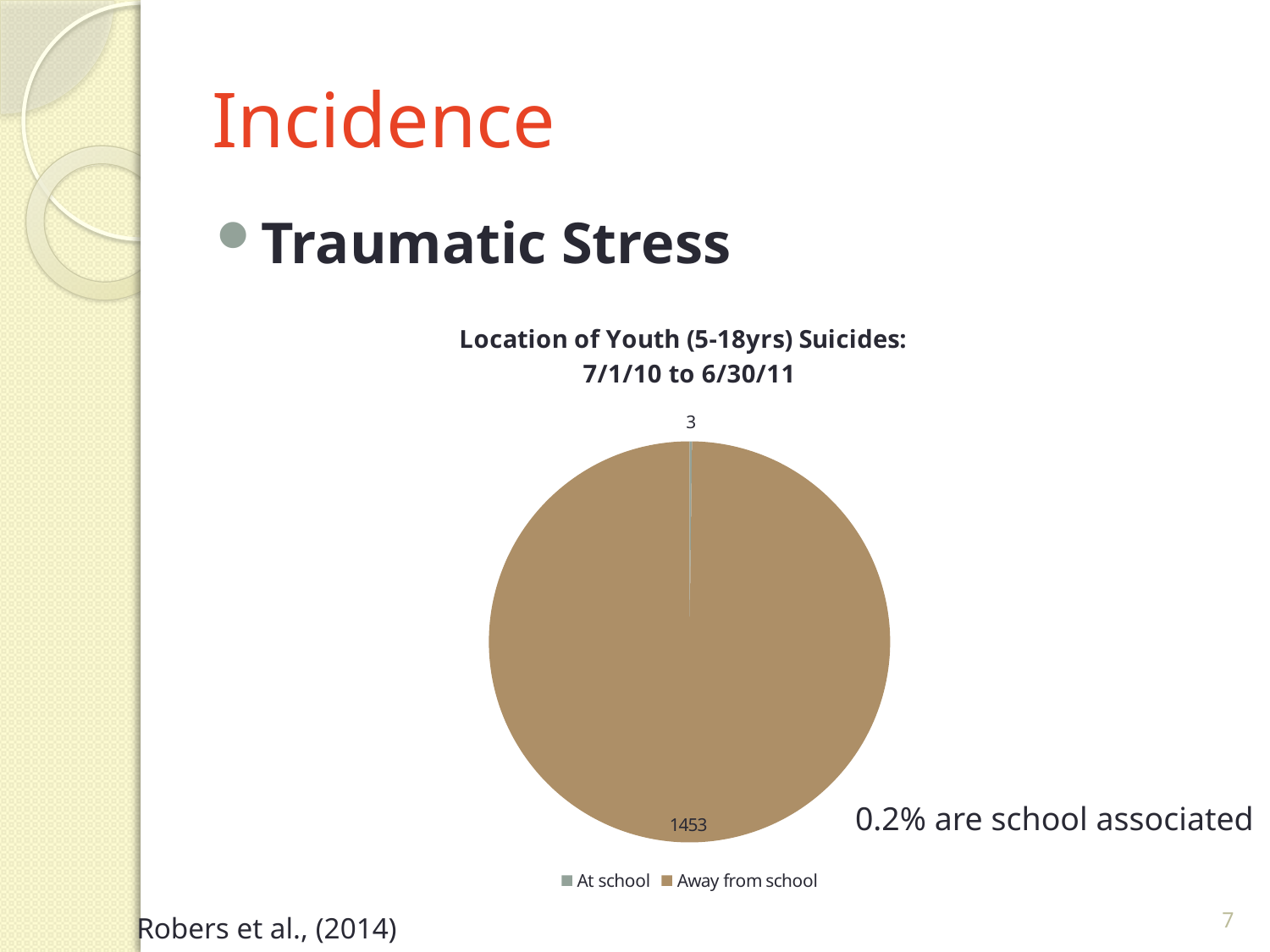
Which is larger: the number of suicides at school or away from school? Away from school What type of chart is shown on the slide? Pie chart What is the total number of youth suicides shown in the pie chart? 1456 How many entries does the legend list? 2 How many youth suicides occurred at school according to the chart? 3 How many slices does the pie chart have? 2 What is the title of the chart? Location of Youth (5-18yrs) Suicides: 7/1/10 to 6/30/11 How many youth suicides occurred away from school according to the chart? 1453 What percentage of youth suicides are school associated, as stated on the slide? 0.2% What is the difference between the number of suicides away from school and at school? 1450 Which category has the smallest slice of the pie? At school Which category has the largest slice of the pie? Away from school